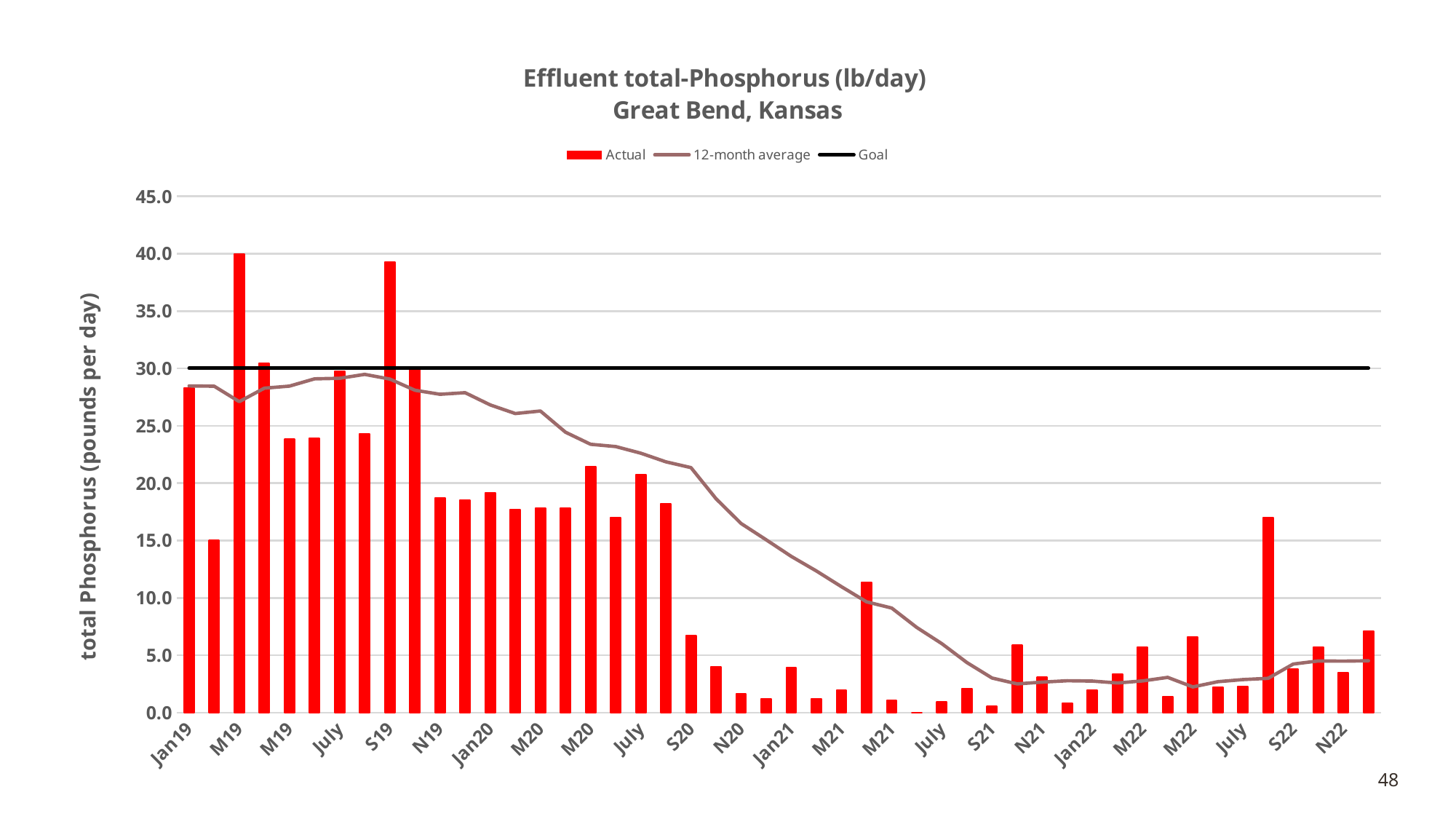
How many series does the legend list? 3 Is the Actual value for Jan21 greater or less than 5.0? less Is the Actual value for S19 greater or less than 35.0? greater Is the 12-month average at S21 greater or less than 5.0? less What is the value of the Goal line? 30.0 What kind of chart is used to show the Actual values on the slide? bar chart What is the title of the chart? Effluent total-Phosphorus (lb/day) Great Bend, Kansas Which has the larger Actual value, Jan19 or Jan20? Jan19 Do the Actual values generally rise or fall from Jan19 to N22? fall